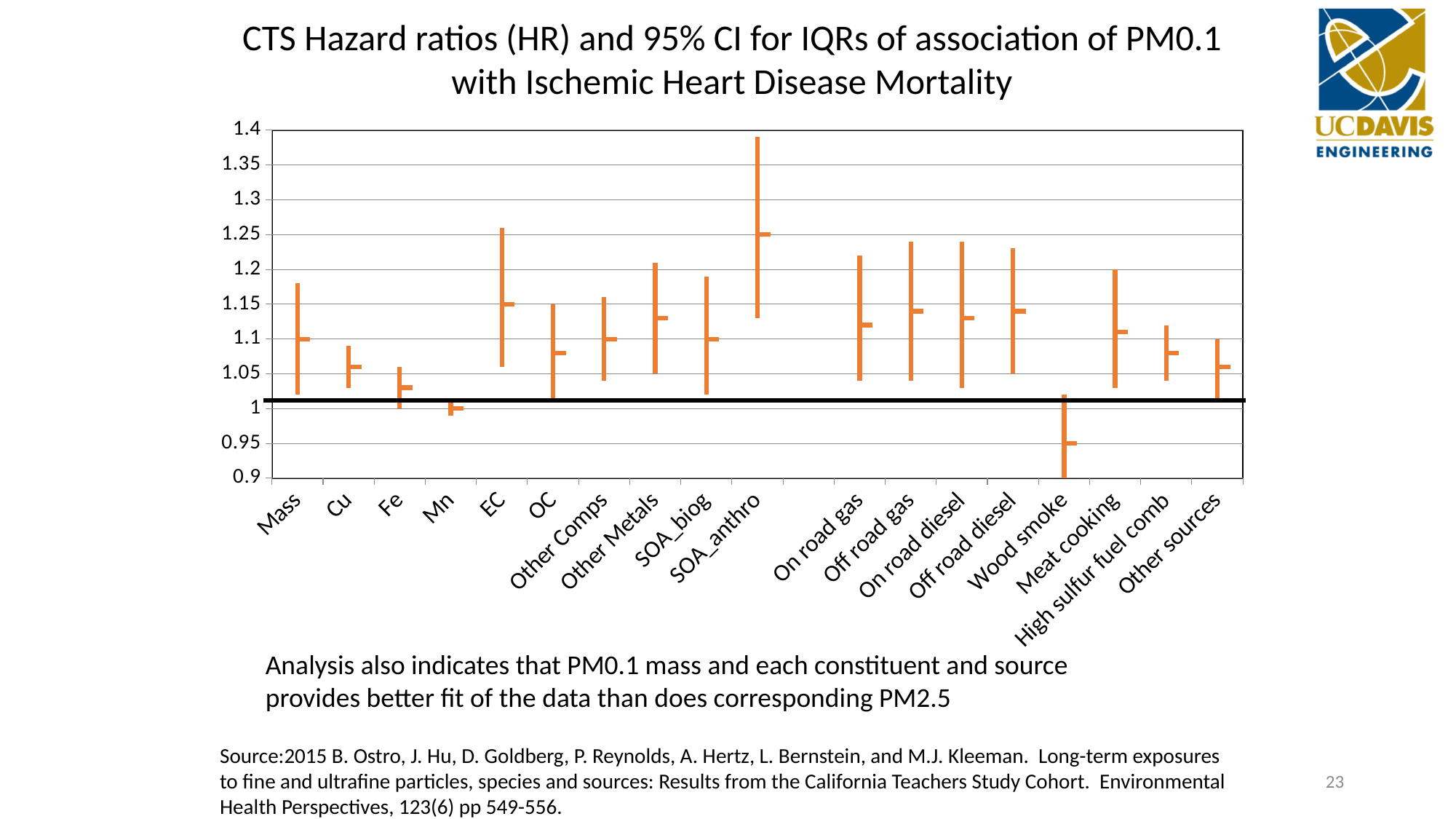
How many categories are shown on the x axis of the chart? 18 What is the title of the chart? CTS Hazard ratios (HR) and 95% CI for IQRs of association of PM0.1 with Ischemic Heart Disease Mortality What is the hazard ratio (central marker) for Wood smoke? 0.95 What is the lowest value shown on the y axis of the chart? 0.9 What is the hazard ratio (central marker) for SOA_anthro? 1.25 Which category has the lowest hazard ratio? Wood smoke Which has the larger hazard ratio, Mn or Wood smoke? Mn What is the hazard ratio (central marker) for Mass? 1.1 Which has the larger hazard ratio, SOA_anthro or Mass? SOA_anthro Is the hazard ratio for Off road gas greater or less than 1.1? greater Is the hazard ratio for Cu greater or less than 1.1? less Which category has the highest hazard ratio? SOA_anthro